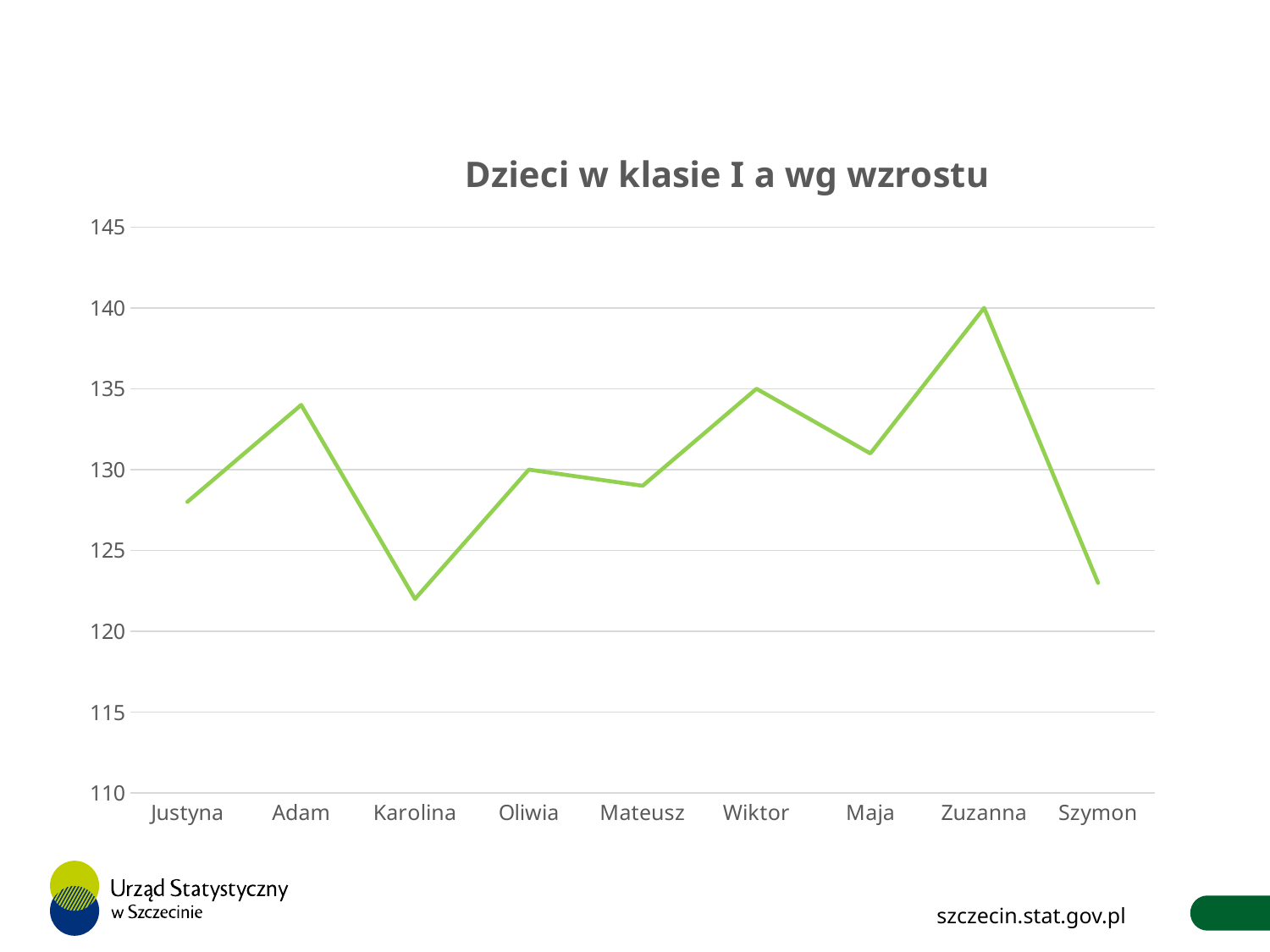
What kind of chart is shown on the slide? line chart What is the title of the chart? Dzieci w klasie I a wg wzrostu Which is larger, the value for Adam or the value for Karolina? Adam What is the value for Zuzanna? 140 What is the value for Wiktor? 135 Is the value for Adam greater or less than 130? greater Is the value for Karolina greater or less than 125? less Is the value for Szymon greater or less than 125? less What is the value for Oliwia? 130 How many children are plotted on the x axis? 9 Which child has the highest value? Zuzanna Does the line rise or fall from Zuzanna to Szymon? fall